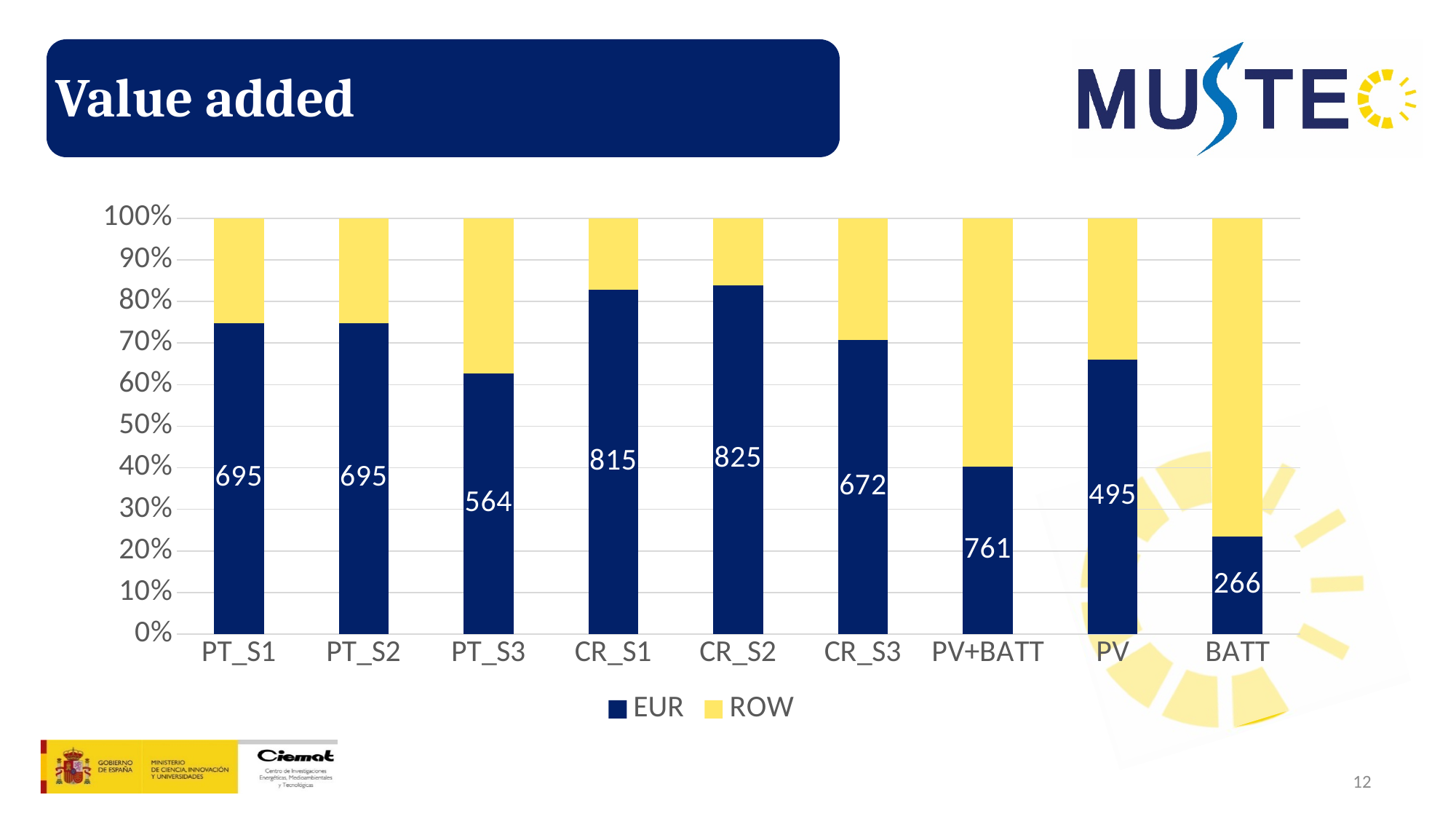
What is the difference between the labelled EUR values for CR_S1 and PT_S1? 120 Which category has the highest labelled EUR value? CR_S2 What value is labelled on the EUR segment of the PT_S3 bar? 564 Which category has the lowest labelled EUR value? BATT What value is labelled on the EUR segment of the PV+BATT bar? 761 Which has a larger labelled EUR value, PV+BATT or CR_S3? PV+BATT What value is labelled on the EUR segment of the CR_S2 bar? 825 How many categories are shown on the x axis? 9 Is the EUR share of the BATT bar greater or less than 30%? less How many series does the legend list? 2 Is the EUR share of the CR_S1 bar greater or less than 80%? greater What type of chart is shown on the slide? Stacked bar chart